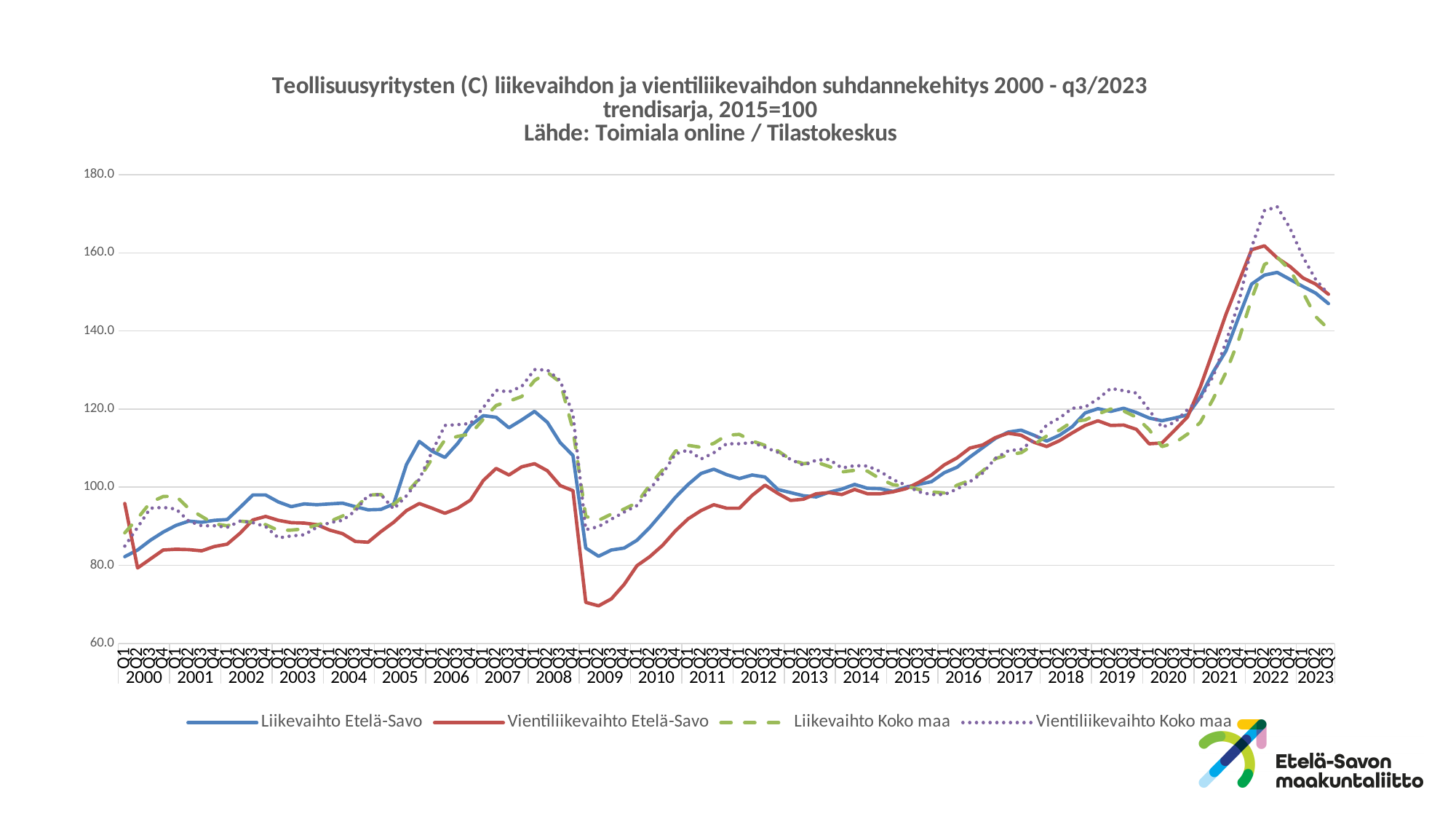
Is the value for Liikevaihto Etelä-Savo in Q3 2022 greater or less than 140? greater Is the value for Vientiliikevaihto Etelä-Savo in Q2 2009 greater or less than 80? less Does Vientiliikevaihto Etelä-Savo rise or fall from Q4 2020 to Q3 2022? rise In Q2 2009, which is higher: Liikevaihto Etelä-Savo or Vientiliikevaihto Etelä-Savo? Liikevaihto Etelä-Savo Is the value for Vientiliikevaihto Etelä-Savo in Q2 2008 greater or less than 100? greater What kind of chart is shown on the slide? line chart According to the chart title, which year is the index base (=100)? 2015 How many series does the legend list? 4 Which series reaches the highest peak on the chart? Vientiliikevaihto Koko maa Which series is drawn as a green dashed line? Liikevaihto Koko maa In Q3 2022, which is higher: Vientiliikevaihto Koko maa or Liikevaihto Etelä-Savo? Vientiliikevaihto Koko maa